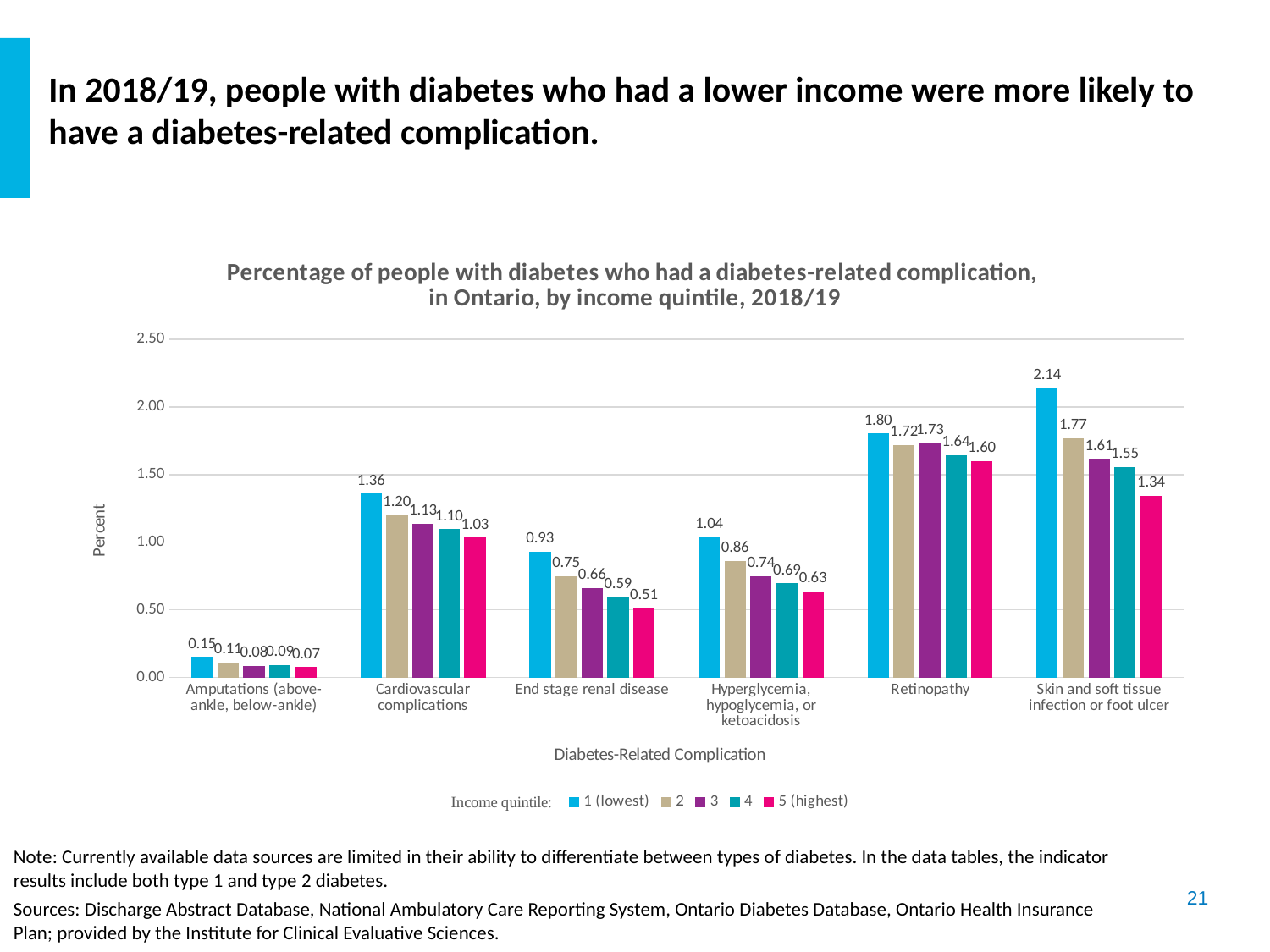
What is the value for income quintile 2 for Cardiovascular complications? 1.20 How many diabetes-related complication categories are shown on the x axis? 6 What is the label of the y axis? Percent How many income quintile series does the legend list? 5 What is the difference between income quintile 1 (lowest) and income quintile 5 (highest) for End stage renal disease? 0.42 Is the value for income quintile 3 for Retinopathy greater or less than 1.50? greater What is the value for income quintile 5 (highest) for Retinopathy? 1.60 Which is larger for Hyperglycemia, hypoglycemia, or ketoacidosis: the value for income quintile 1 (lowest) or income quintile 2? 1 (lowest) What is the value for income quintile 1 (lowest) for Skin and soft tissue infection or foot ulcer? 2.14 What kind of chart is shown on the slide? Bar chart Which complication has the highest value for income quintile 1 (lowest)? Skin and soft tissue infection or foot ulcer Which complication has the lowest value for income quintile 5 (highest)? Amputations (above-ankle, below-ankle)